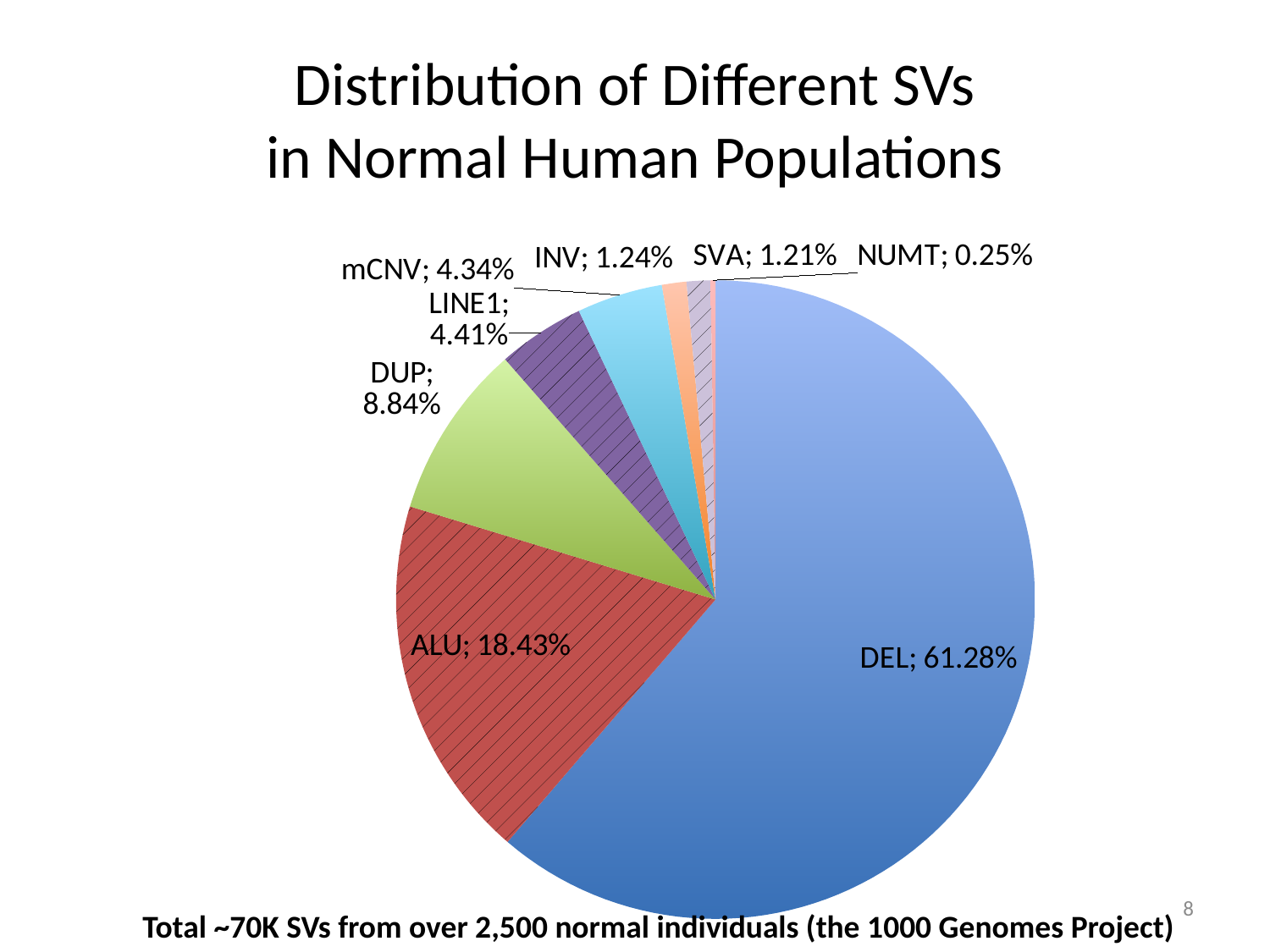
What is the value shown for ALU? 18.43% How many slices does the pie chart have? 8 What is the title of the chart? Distribution of Different SVs in Normal Human Populations What share of the pie does DEL account for? 61.28% What is the value shown for DUP? 8.84% Which is larger, the DUP slice or the mCNV slice? DUP What is the value shown for mCNV? 4.34% Which SV type has the smallest slice of the pie? NUMT Which SV type has the largest slice of the pie? DEL What kind of chart is shown on the slide? pie chart What is the value shown for NUMT? 0.25% What is the difference between the DEL and ALU percentages? 42.85%